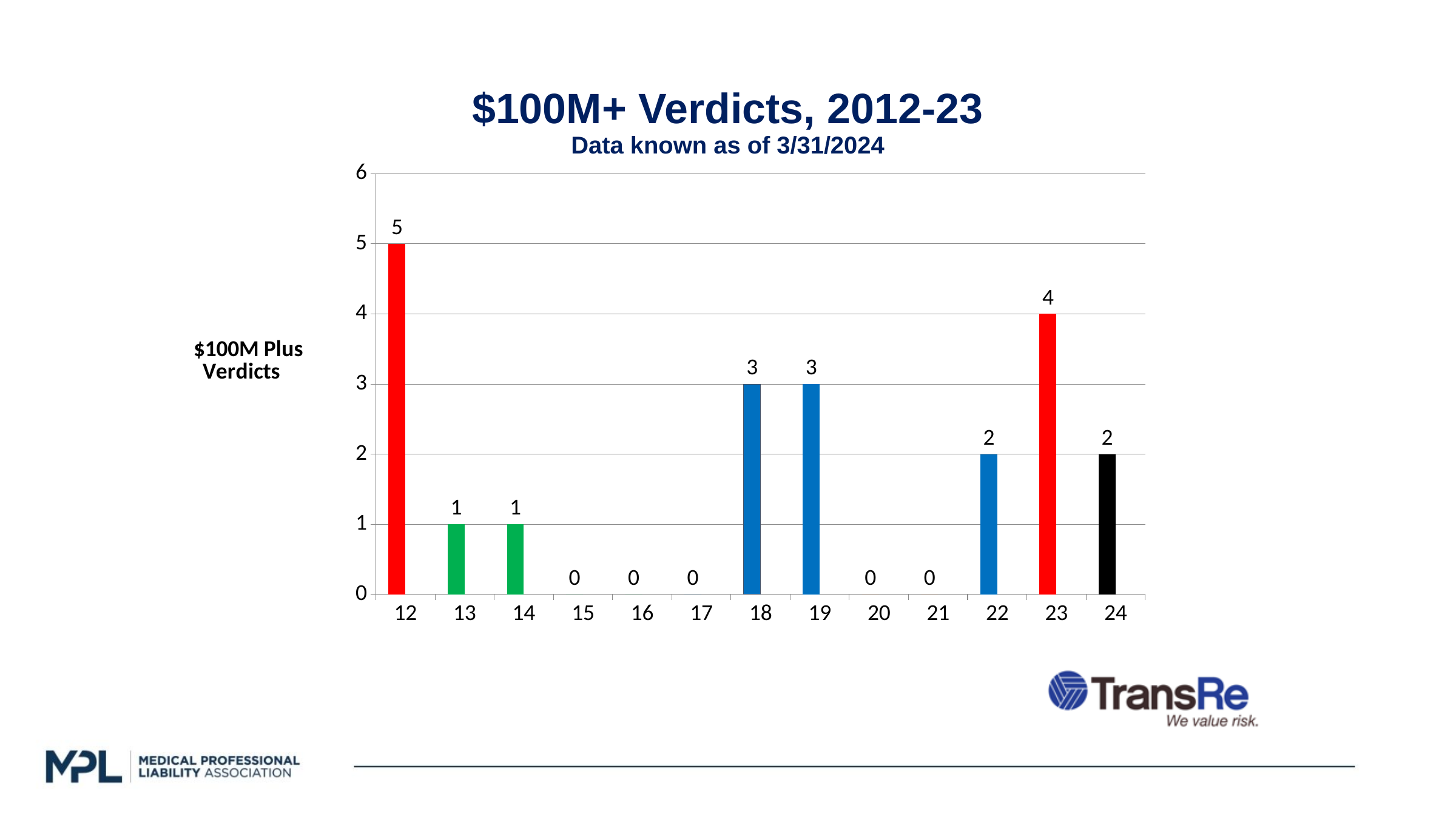
What is the value for 24 in the $100M+ Verdicts chart? 2 Which year has the highest value in the $100M+ Verdicts chart? 12 What is the title of the chart on the slide? $100M+ Verdicts, 2012-23 What is the value for 18 in the $100M+ Verdicts chart? 3 How many years have a value of 0 in the chart? 5 What is the value for 23 in the $100M+ Verdicts chart? 4 How many categories are shown on the x axis of the chart? 13 What is the difference between the values for 12 and 23? 1 What kind of chart is shown on the slide? bar chart Which is larger, the value for 13 or the value for 22? 22 What is the difference between the values for 18 and 22? 1 What is the value for 12 in the $100M+ Verdicts chart? 5